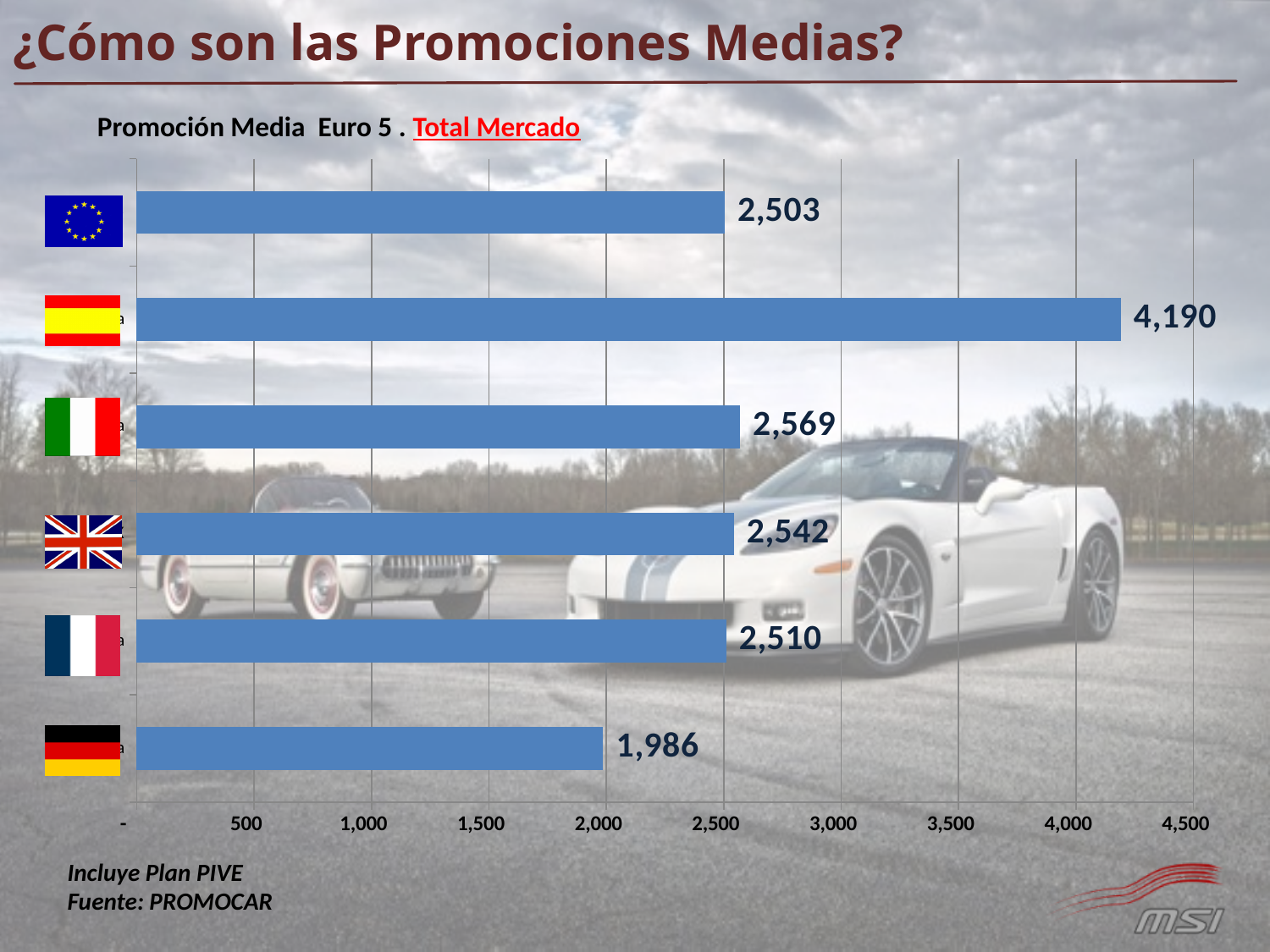
What is the difference between the Italian bar and the European Union bar? 66 Which country's bar has the highest value? Spain Is the value for Germany greater or less than 2,000? less How many bars are shown in the chart? 6 What is the difference between the Spanish bar and the German bar? 2,204 What kind of chart is shown on the slide? bar chart Which is larger, the value for Spain or the value for the European Union? Spain What is the value of the bar marked with the French flag? 2,510 What is the value of the bar marked with the German flag? 1,986 What is the value of the bar marked with the Spanish flag? 4,190 What is the value of the bar marked with the European Union flag? 2,503 Which country's bar has the lowest value? Germany